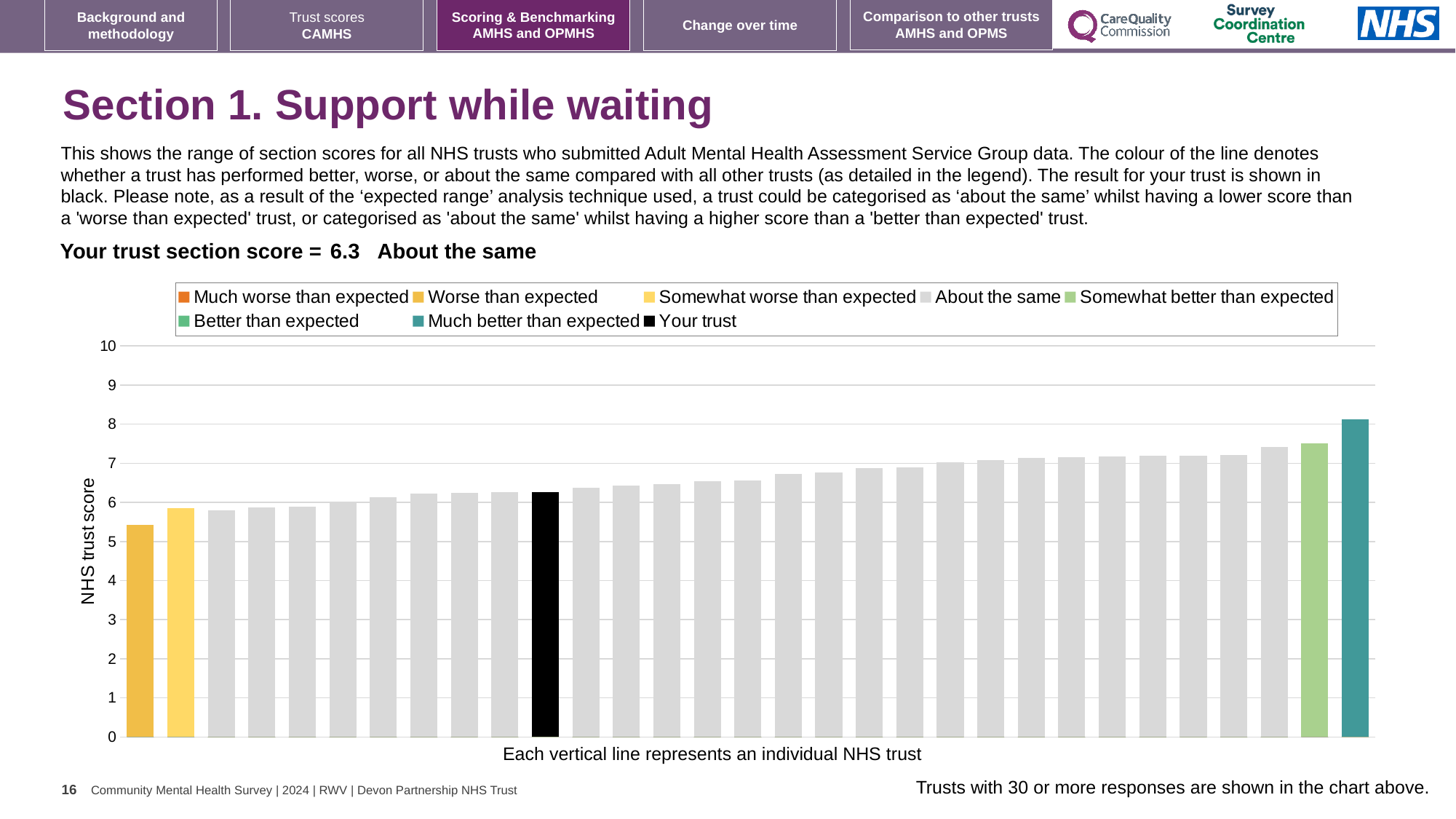
Is the rightmost bar larger or smaller than the leftmost bar? larger Is the value of the black 'Your trust' bar greater or less than 7? less Which legend category does the tallest bar in the chart belong to? Much better than expected What kind of chart is shown on the slide? bar chart Is the value of the leftmost bar greater or less than 6? less Do the bar values rise or fall from left to right across the chart? rise Is the value of the black 'Your trust' bar greater or less than 6? greater What is the label on the vertical axis of the chart? NHS trust score What is the section score for your trust shown on the slide? 6.3 What colour is used for the 'Your trust' bar in the chart? black How many entries does the chart legend list? 8